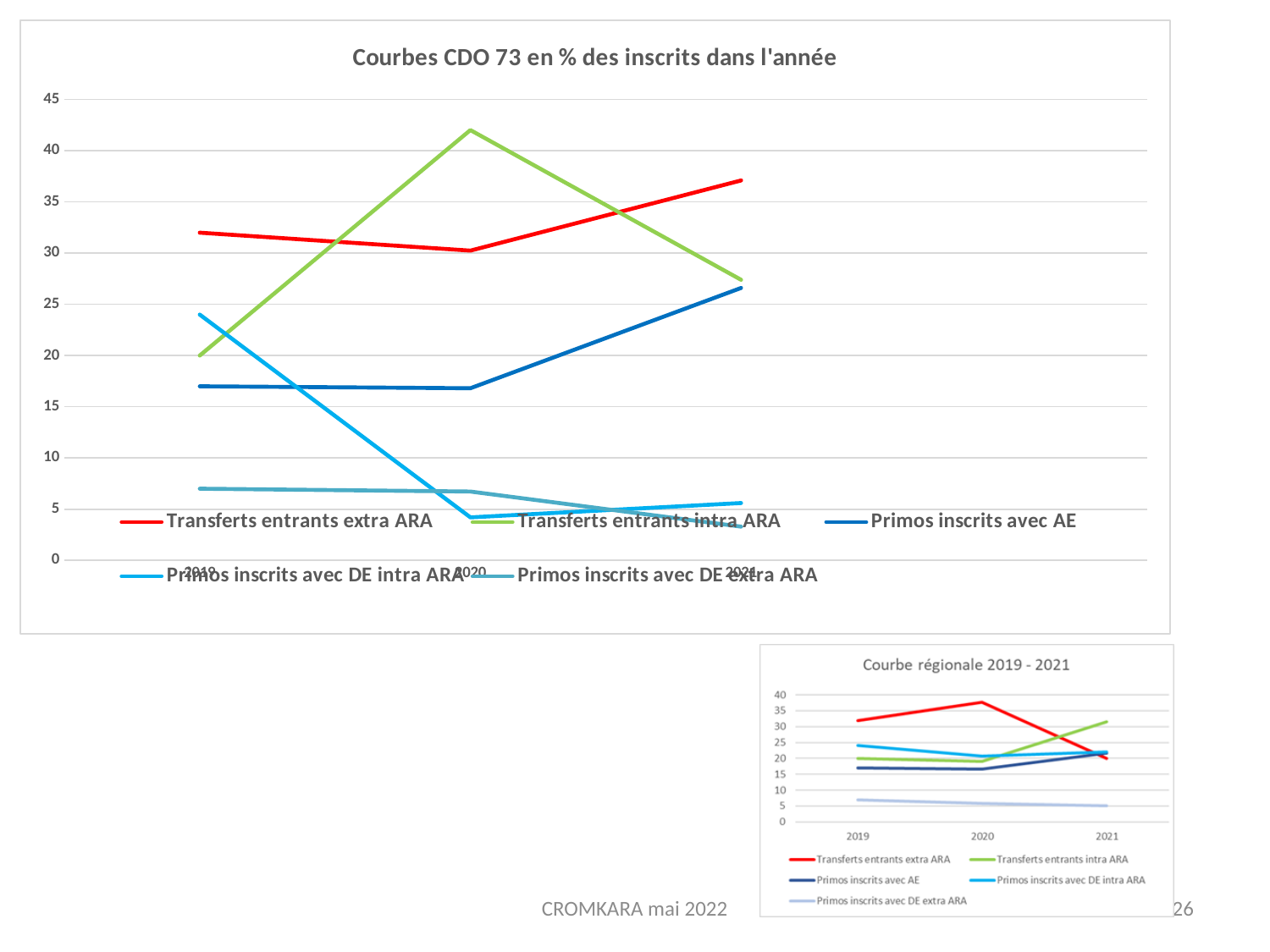
In the chart "Courbe régionale 2019 - 2021", does the Transferts entrants extra ARA line rise or fall from 2020 to 2021? fall In the chart "Courbe régionale 2019 - 2021", which series has the highest value in 2020? Transferts entrants extra ARA In the chart "Courbe régionale 2019 - 2021", is the value for Transferts entrants intra ARA in 2021 greater or less than 25? greater In the chart "Courbes CDO 73 en % des inscrits dans l'année", is the value for Primos inscrits avec DE intra ARA in 2020 greater or less than 10? less In the chart "Courbes CDO 73 en % des inscrits dans l'année", does the Primos inscrits avec AE line rise or fall from 2020 to 2021? rise In the chart "Courbes CDO 73 en % des inscrits dans l'année", is the value for Transferts entrants intra ARA in 2020 greater or less than 40? greater In the chart "Courbes CDO 73 en % des inscrits dans l'année", which is larger in 2021: Transferts entrants extra ARA or Transferts entrants intra ARA? Transferts entrants extra ARA In the chart "Courbes CDO 73 en % des inscrits dans l'année", how many series does the legend list? 5 In the chart "Courbes CDO 73 en % des inscrits dans l'année", which series has the highest value in 2020? Transferts entrants intra ARA In the chart "Courbes CDO 73 en % des inscrits dans l'année", which series has the lowest value in 2021? Primos inscrits avec DE extra ARA In the chart "Courbes CDO 73 en % des inscrits dans l'année", how many years are shown on the x axis? 3 What type of chart is the chart titled "Courbes CDO 73 en % des inscrits dans l'année"? line chart